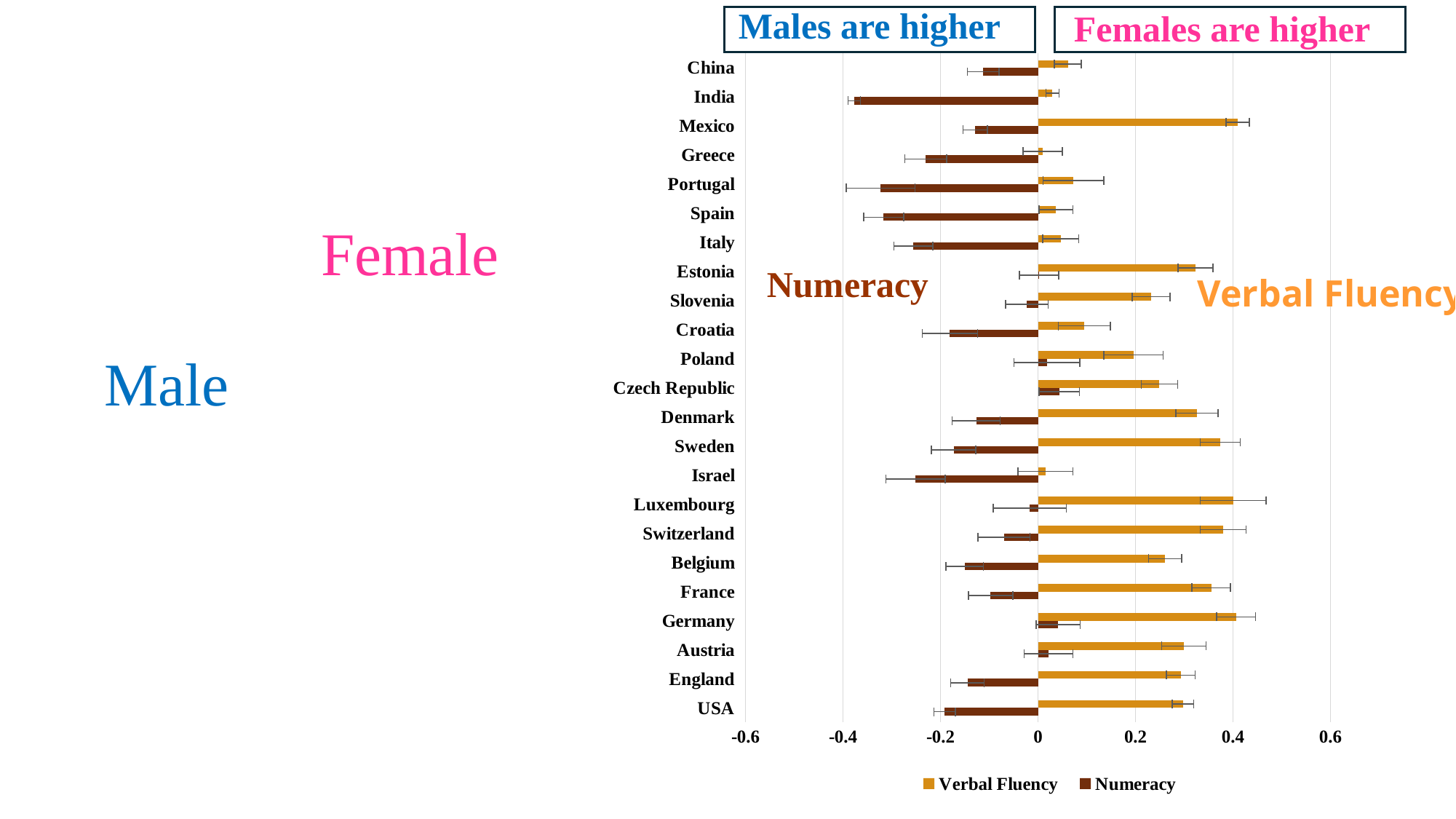
Which country has the lowest (most negative) Numeracy value? India Is the Numeracy value for India greater or less than -0.2? less Is the Verbal Fluency value for Mexico greater or less than 0.2? greater Which has the larger Verbal Fluency value, Mexico or Poland? Mexico Is the Verbal Fluency value for Sweden greater or less than 0.2? greater According to the label above the chart, which side of the chart indicates that males are higher? the left side Which series is shown in dark brown in the legend? Numeracy How many series does the legend list? 2 What kind of chart is shown on the slide? bar chart How many countries are plotted on the chart? 23